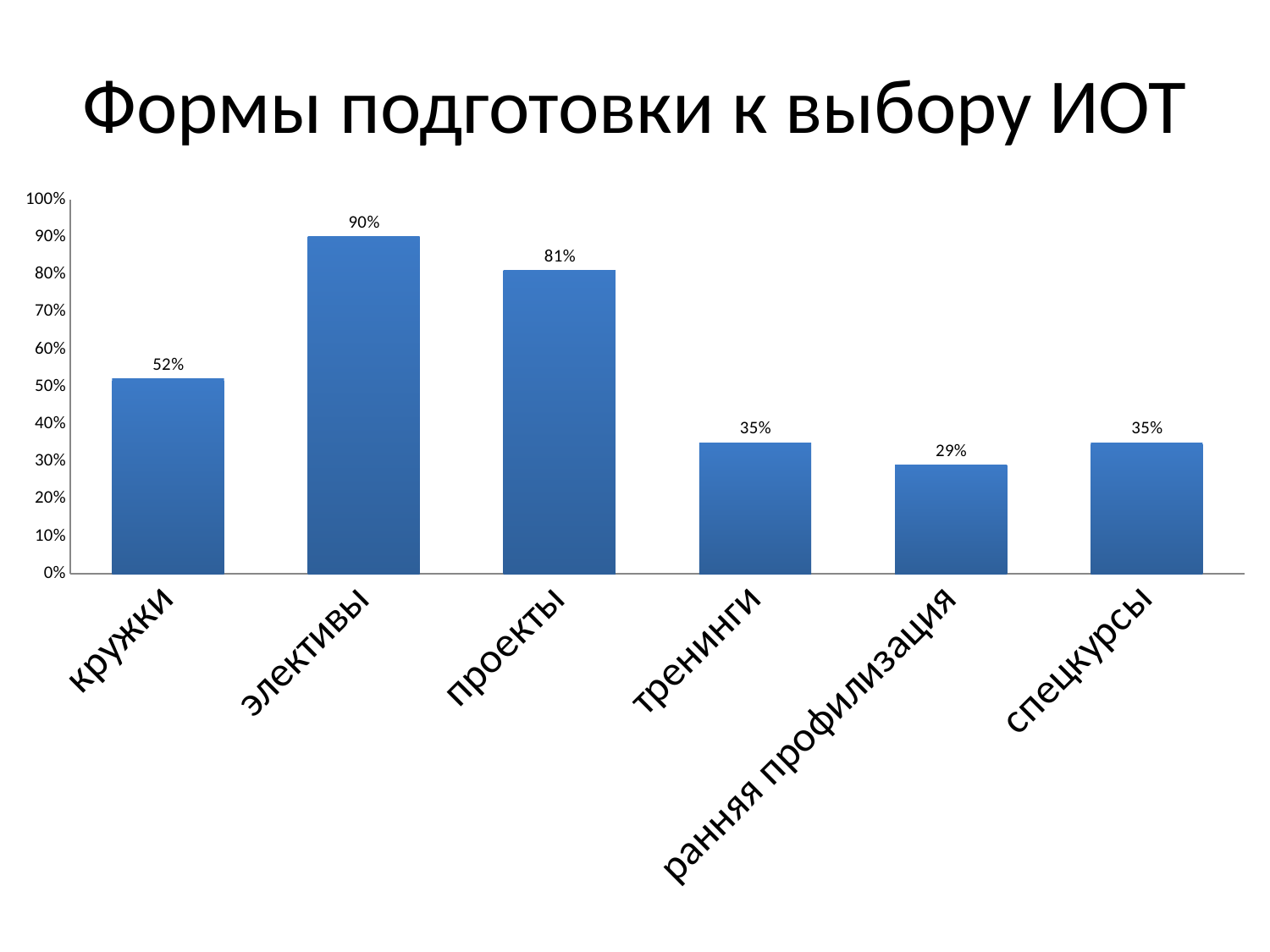
What is the value for ранняя профилизация? 29% What is the difference between the values for элективы and проекты? 9% What is the value for проекты? 81% What is the title of the slide? Формы подготовки к выбору ИОТ Which category has the lowest value? ранняя профилизация What is the difference between the values for кружки and тренинги? 17% What is the value for элективы? 90% What kind of chart is shown on the slide? bar chart What is the value for кружки? 52% How many categories are shown on the x axis? 6 Which category has the highest value? элективы Which is larger, the value for кружки or the value for спецкурсы? кружки